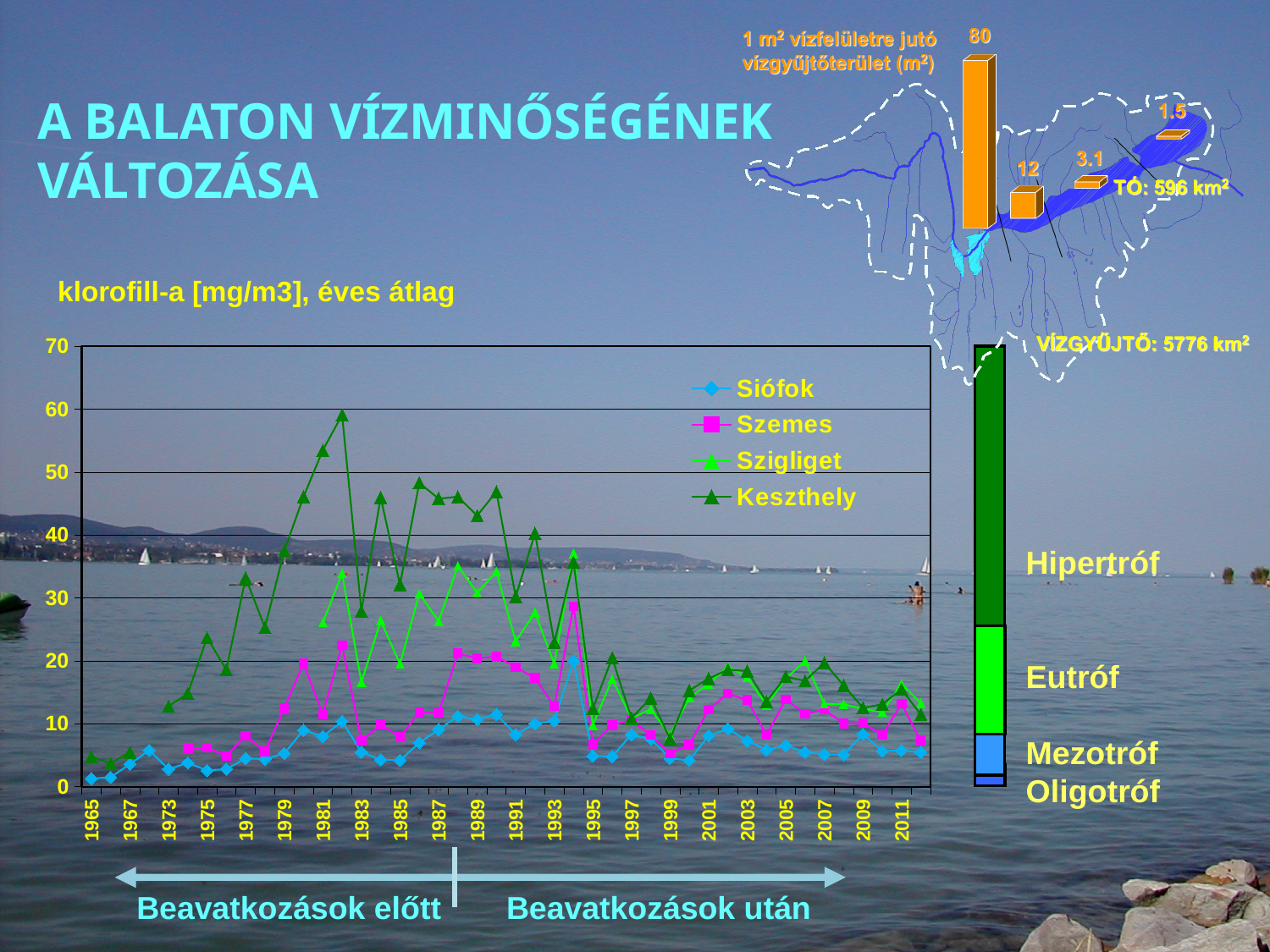
In the chlorophyll-a line chart, is the value for Siófok in 1965 greater or less than 10? less In the small bar chart on the map (catchment area per 1 m² of water surface), what is the difference between the two largest values, 80 and 12? 68 What kind of chart is the large chart showing chlorophyll-a values by year? line chart In the small bar chart on the map (catchment area per 1 m² of water surface), what is the highest value shown? 80 In the chlorophyll-a line chart, which is larger in 1982: Keszthely or Siófok? Keszthely In the chlorophyll-a line chart, is the value for Szemes in 1994 greater or less than 20? greater In the chlorophyll-a line chart, which series reaches the highest value overall? Keszthely Which series are listed in the legend of the chlorophyll-a line chart? Siófok, Szemes, Szigliget, Keszthely What is the label above the chlorophyll-a line chart describing the plotted quantity? klorofill-a [mg/m3], éves átlag In the chlorophyll-a line chart, is the value for Keszthely in 1982 greater or less than 50? greater In the chlorophyll-a line chart, does the Keszthely series rise or fall from 1973 to 1982? rise How many series does the legend of the chlorophyll-a line chart list? 4